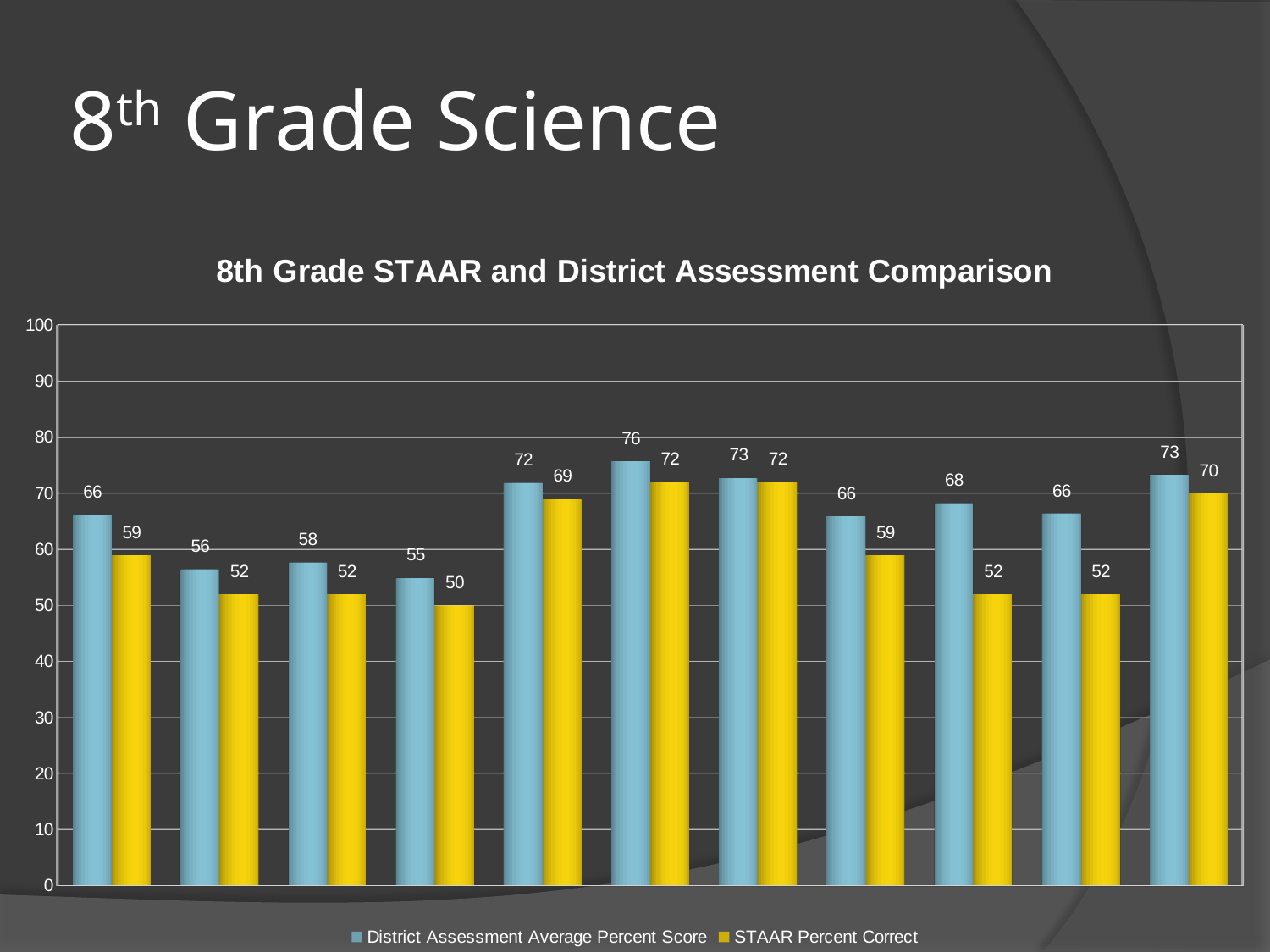
What is the STAAR Percent Correct value for the last (rightmost) group of bars? 70 What is the District Assessment Average Percent Score value for the first (leftmost) group of bars? 66 Is the highest District Assessment Average Percent Score value greater or less than 70? greater What is the highest value shown for the District Assessment Average Percent Score series? 76 How many series does the legend list? 2 Which series is shown in yellow? STAAR Percent Correct How many groups of bars are plotted in the chart? 11 In the leftmost group of bars, what is the difference between the District Assessment Average Percent Score and the STAAR Percent Correct? 7 What is the title of the chart? 8th Grade STAAR and District Assessment Comparison In the group with the tallest bar, which series has the larger value? District Assessment Average Percent Score What is the lowest value shown for the STAAR Percent Correct series? 50 What kind of chart is shown on the slide? bar chart